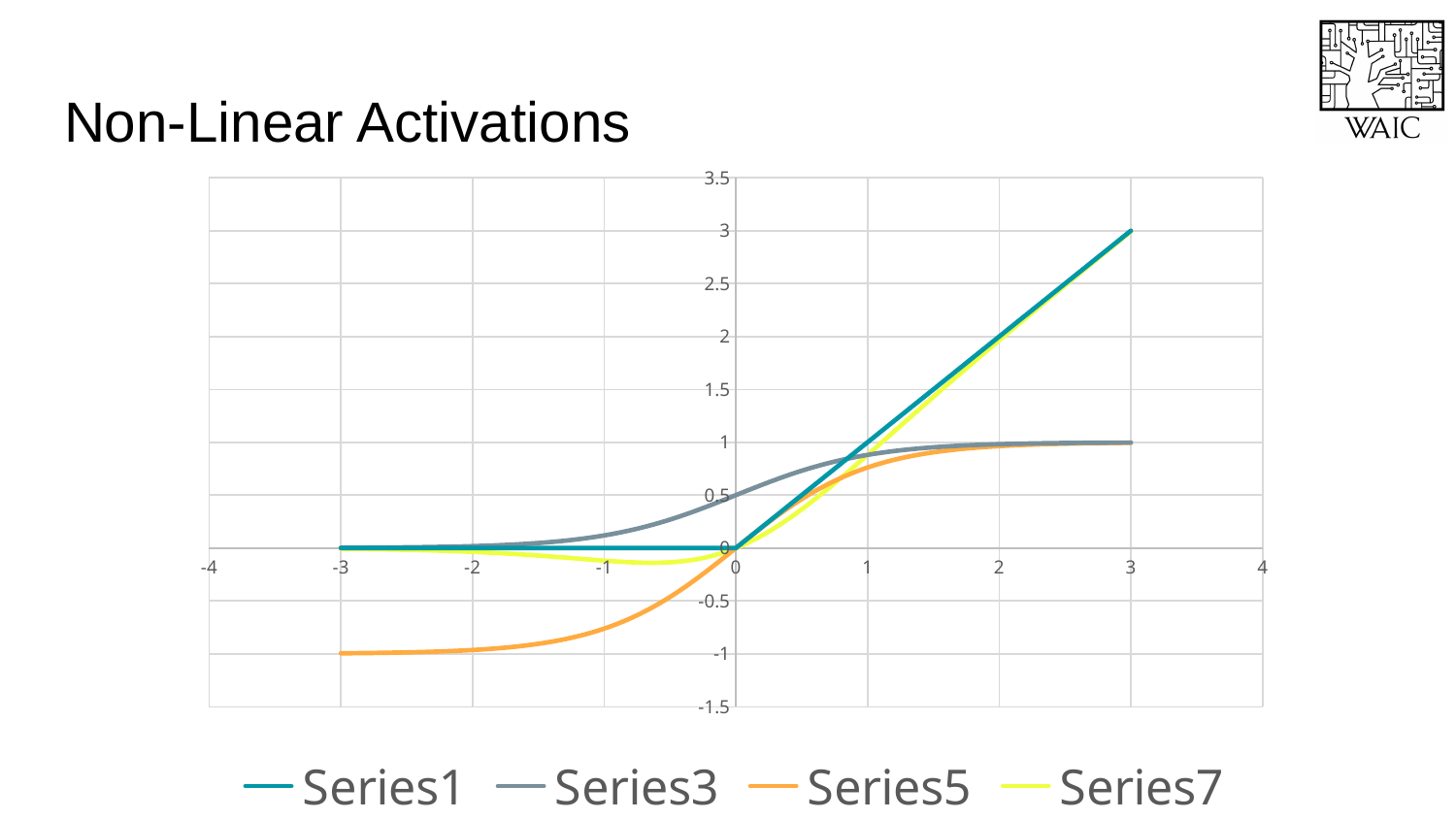
What is the value of Series1 at x = 3? 3 Is the value of Series1 at x = 2 greater or less than 1.5? greater How many series does the legend list? 4 Which series is drawn in orange according to the legend? Series5 At x = -2, which is larger: the value of Series3 or the value of Series5? Series3 What is the value of Series3 at x = 0? 0.5 Which series has the lowest value at x = -3? Series5 What kind of chart is shown on the slide? Line chart What is the title of the slide containing the chart? Non-Linear Activations Is the value of Series3 at x = 3 greater or less than 1.5? less